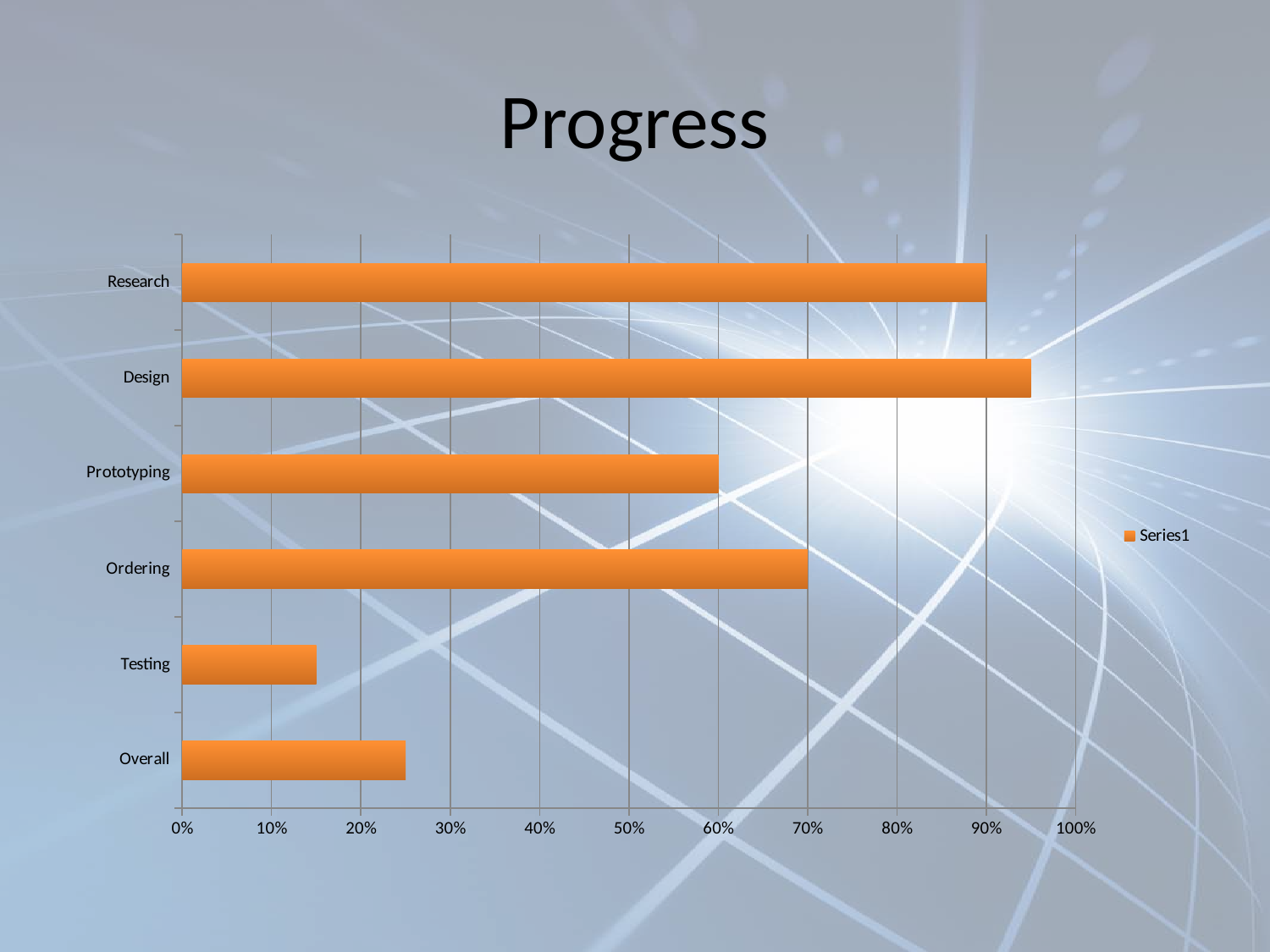
Which category has the lowest value? Testing How many series does the legend list? 1 Is the value for Design greater or less than 90%? greater What is the value for Prototyping? 60% What is the difference between the values for Ordering and Prototyping? 10% What is the value for Research? 90% What type of chart is shown on the slide? bar chart What is the value for Ordering? 70% What is the title of the chart? Progress Which category has the highest value? Design How many categories are shown on the chart? 6 Is the value for Overall greater or less than 30%? less